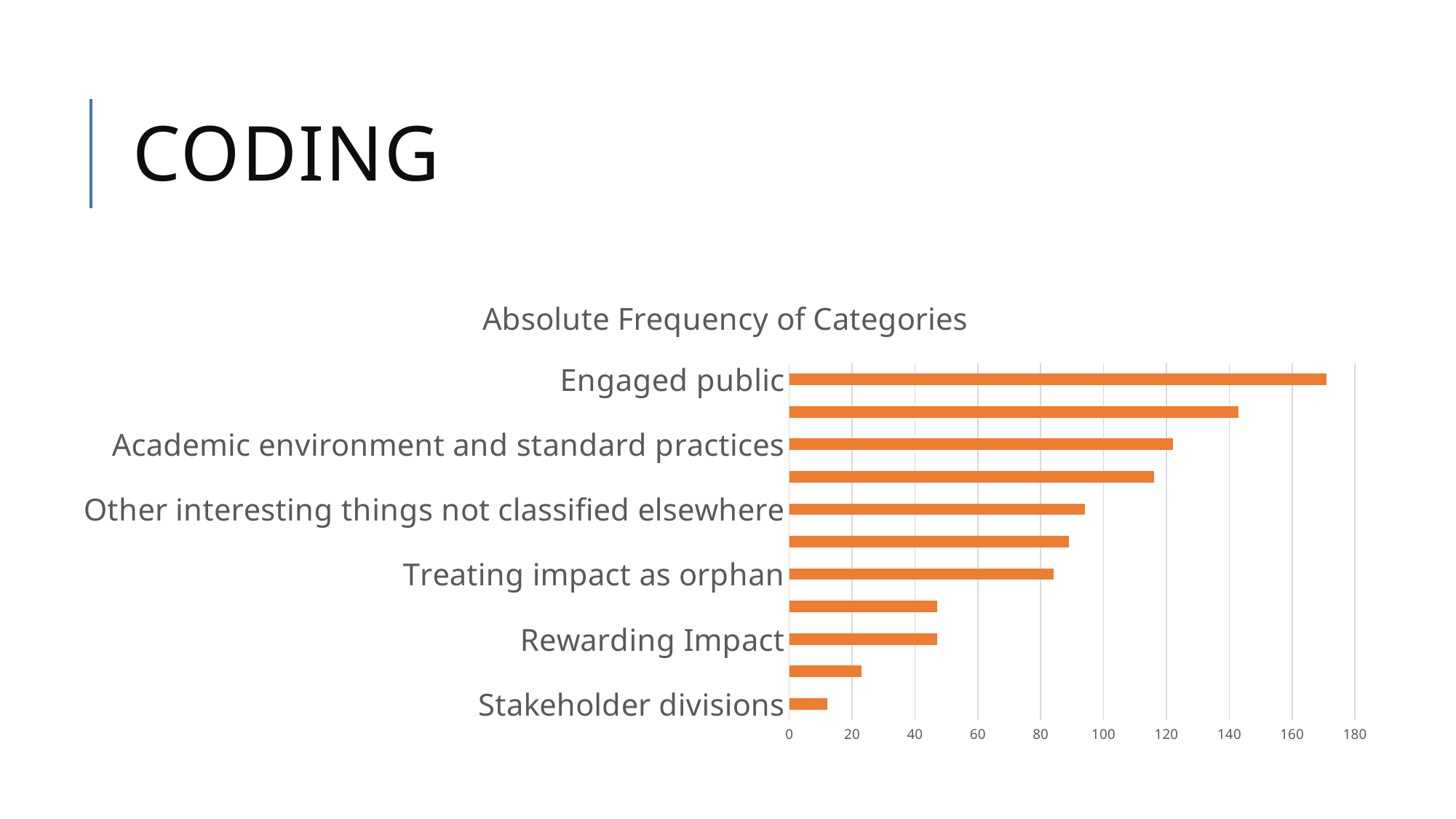
Is the value for Rewarding Impact greater or less than 40? greater Is the value for Other interesting things not classified elsewhere greater or less than 100? less What is the title of the chart? Absolute Frequency of Categories Which labelled category has the lowest value? Stakeholder divisions What kind of chart is shown on the slide? bar chart Which labelled category has the highest value? Engaged public Is the value for Stakeholder divisions greater or less than 20? less Which is larger, the value for Engaged public or the value for Treating impact as orphan? Engaged public How many bars are plotted in the chart? 11 Do the bar values increase or decrease going from the top of the chart to the bottom? decrease